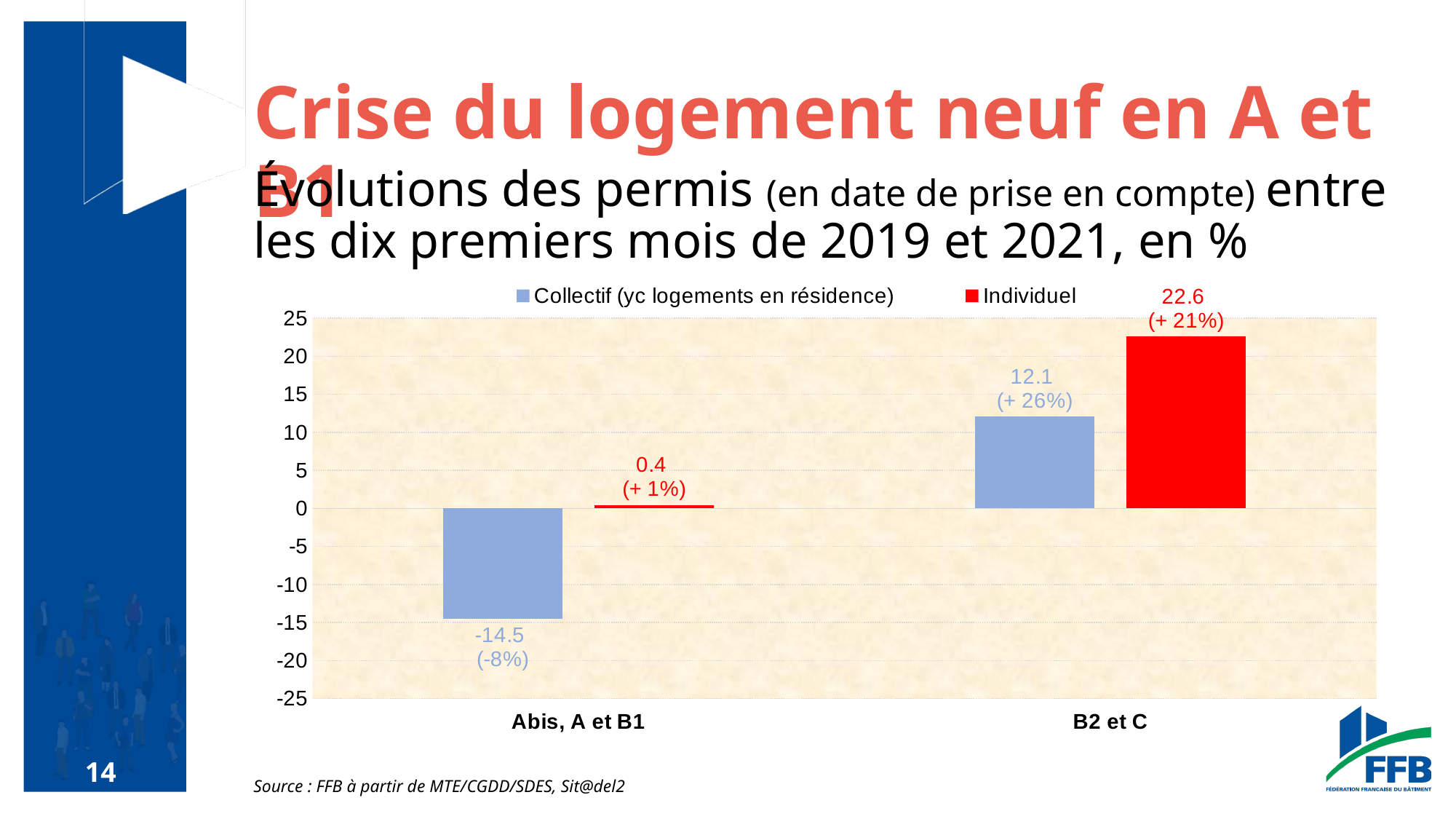
What is the difference between the Individuel and Collectif values in the B2 et C category? 10.5 Which bar has the highest value on the chart? Individuel, B2 et C What is the value for Individuel in the B2 et C category? 22.6 What is the value for Individuel in the Abis, A et B1 category? 0.4 What is the value for Collectif (yc logements en résidence) in the B2 et C category? 12.1 How many categories are shown on the x axis? 2 What kind of chart is shown on the slide? Bar chart What percentage change is shown in parentheses for the Collectif bar in the B2 et C category? + 26% What is the value for Collectif (yc logements en résidence) in the Abis, A et B1 category? -14.5 In the B2 et C category, which series has the larger value, Collectif or Individuel? Individuel Which bar has the lowest value on the chart? Collectif (yc logements en résidence), Abis, A et B1 How many series does the legend list? 2